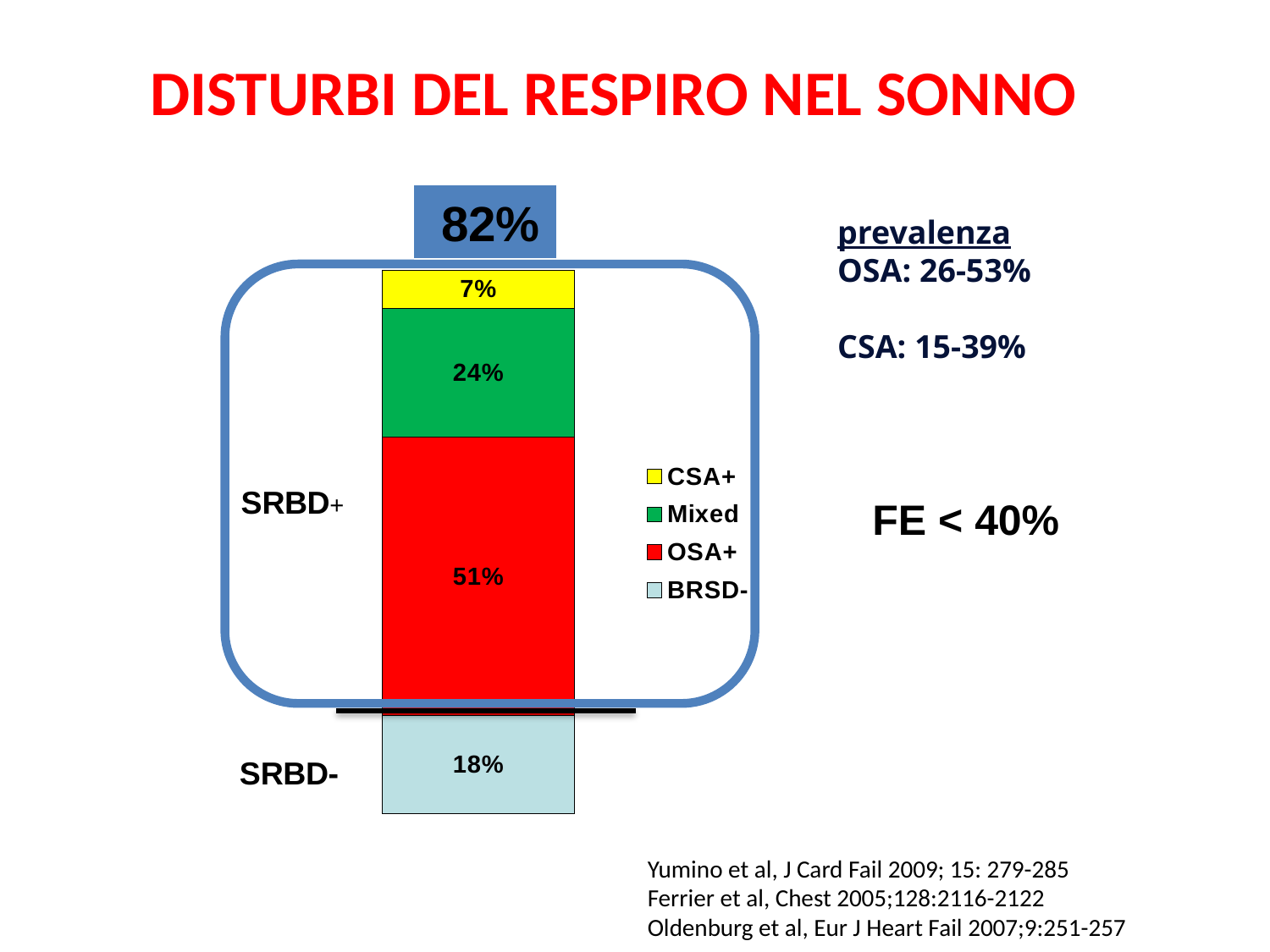
What percentage is shown for the CSA+ segment of the stacked bar? 7% How many series does the chart legend list? 4 What percentage is shown for the OSA+ segment of the stacked bar? 51% What kind of chart is shown on the slide? Stacked bar chart What percentage is shown for the Mixed segment of the stacked bar? 24% What is the combined total of the CSA+, Mixed and OSA+ segments (the SRBD+ group)? 82% What is the difference between the OSA+ and Mixed segment values? 27% Which segment of the stacked bar has the smallest value? CSA+ What percentage is shown for the BRSD- segment of the stacked bar? 18% Which segment of the stacked bar has the largest value? OSA+ What colour is used for the OSA+ segment in the chart? Red Which is larger, the Mixed segment or the BRSD- segment? Mixed